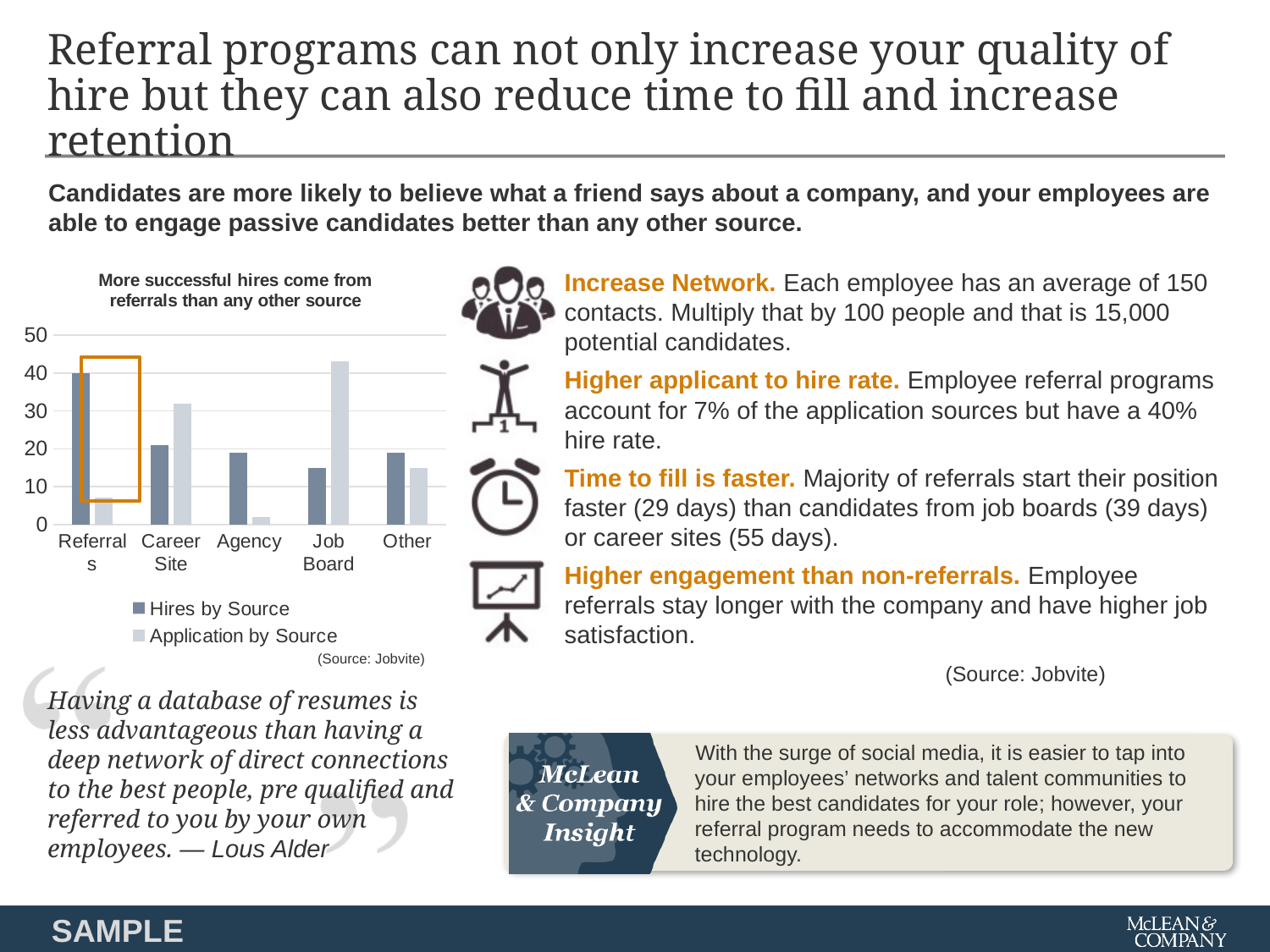
How many categories are shown on the x axis of the chart? 5 Which category has the highest value for Hires by Source? Referrals Is the Hires by Source value for Referrals greater or less than 30? greater Is the Application by Source value for Job Board greater or less than 40? greater How many series does the chart's legend list? 2 Is the Application by Source value for Referrals greater or less than 10? less For Career Site, which is larger: Hires by Source or Application by Source? Application by Source What kind of chart is shown on the slide? bar chart What is the title of the chart? More successful hires come from referrals than any other source Which category has the lowest value for Hires by Source? Job Board Which category has the lowest value for Application by Source? Agency Which category has the highest value for Application by Source? Job Board